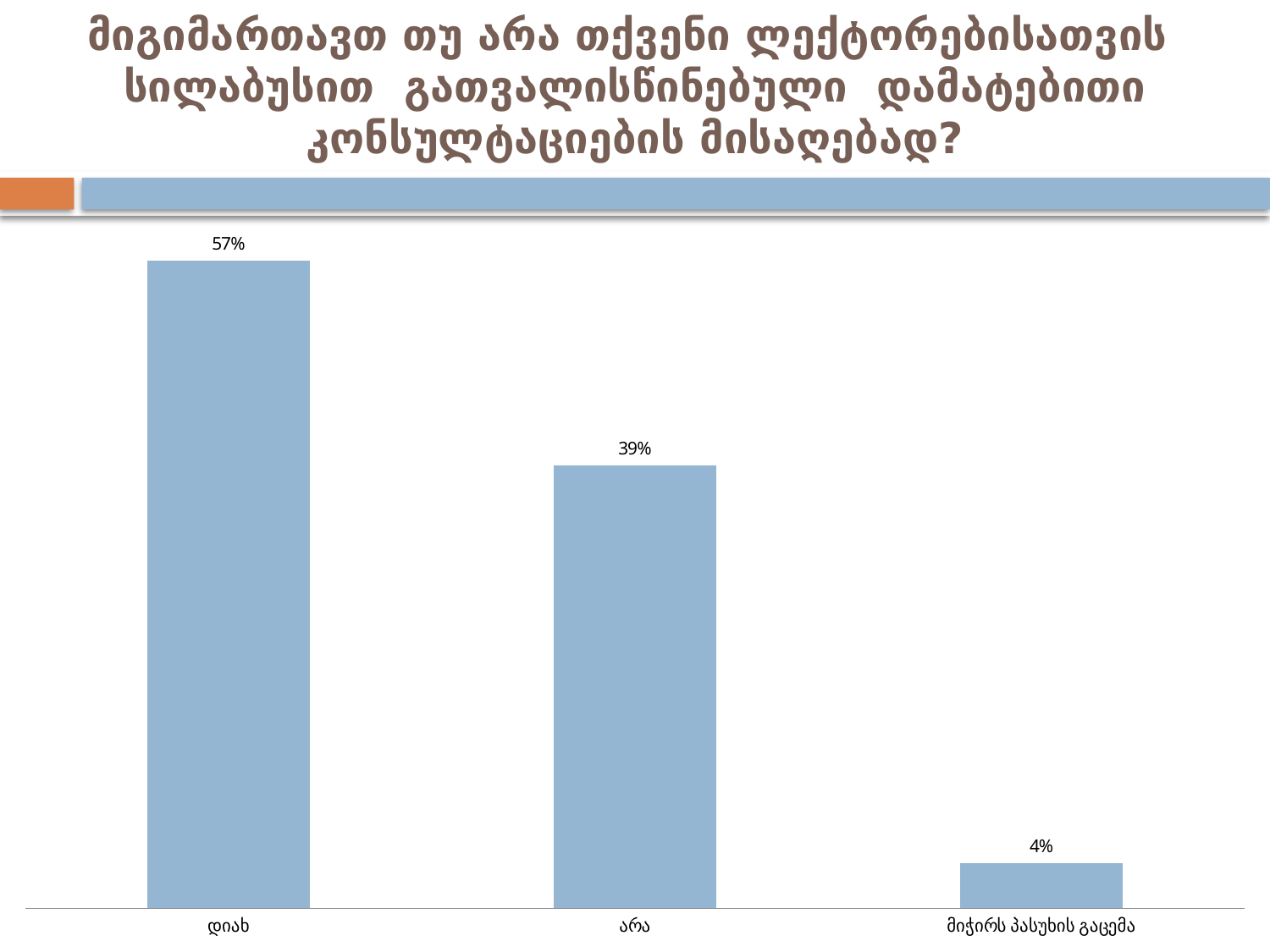
What is the difference between the values for დიახ and არა? 18% What is the value for მიჭირს პასუხის გაცემა? 4% Do the values rise or fall from left to right across the categories? fall How many categories are shown in the chart? 3 What colour are the bars in the chart? light blue What kind of chart is shown on the slide? bar chart What is the difference between the values for არა and მიჭირს პასუხის გაცემა? 35% What is the value for დიახ? 57% Which is larger, the value for დიახ or the value for არა? დიახ Which category has the highest value? დიახ What is the value for არა? 39% Which category has the lowest value? მიჭირს პასუხის გაცემა